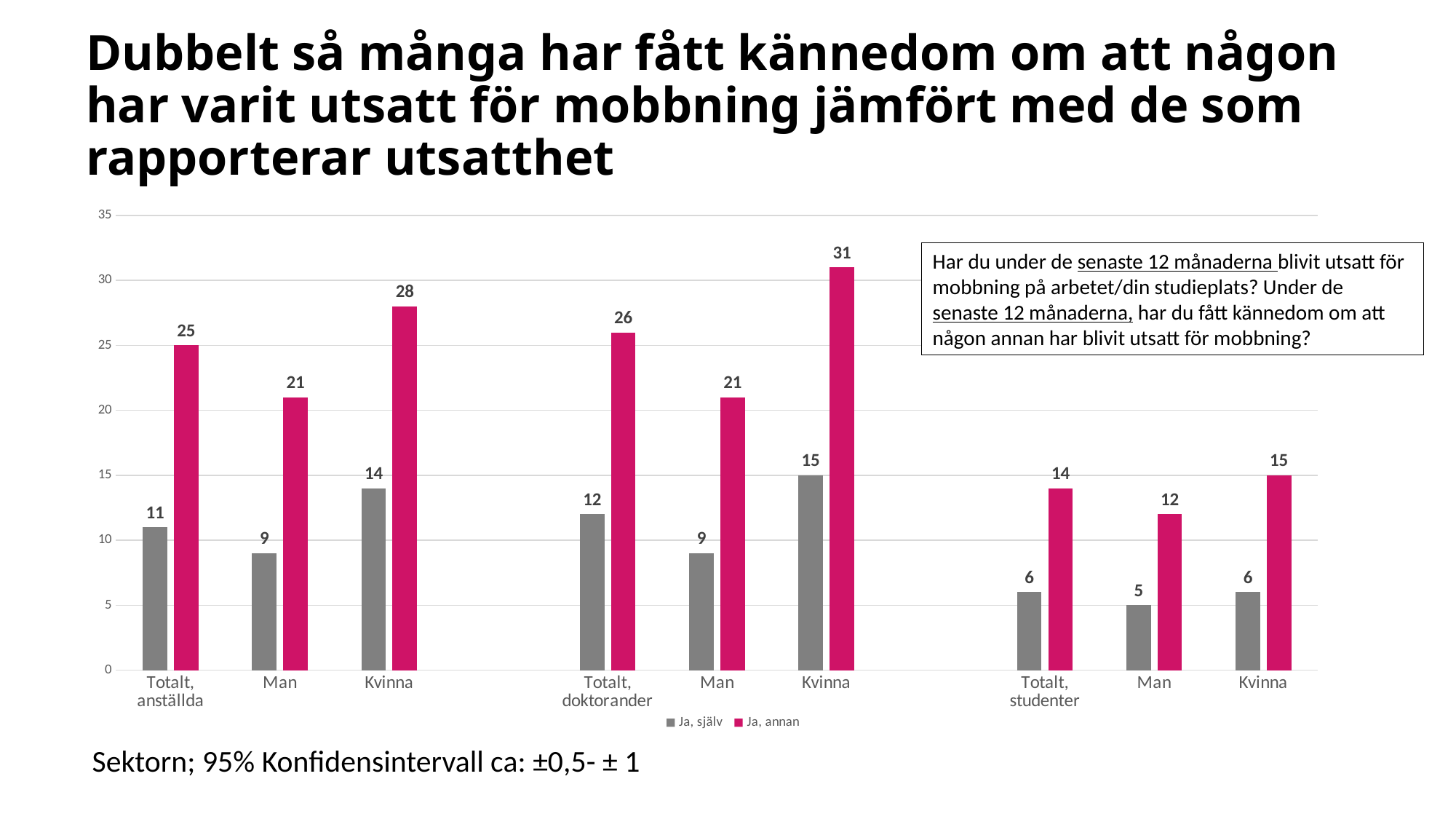
What is the value of "Ja, själv" for the "Kvinna" category in the anställda group? 14 How many series does the legend list? 2 Which category has the highest "Ja, annan" value? Kvinna (doktorander) What is the value of "Ja, annan" for "Totalt, anställda"? 25 Which series is shown in magenta/pink? Ja, annan How many categories are shown on the x axis? 9 Which is larger: the "Ja, annan" value for Kvinna among anställda or for Kvinna among doktorander? Kvinna among doktorander What is the difference between "Ja, annan" and "Ja, själv" for "Totalt, studenter"? 8 Which category has the lowest "Ja, själv" value? Man (studenter) What kind of chart is shown on the slide? Bar chart What is the value of "Ja, annan" for the "Man" category in the studenter group? 12 What is the value of "Ja, själv" for "Totalt, doktorander"? 12